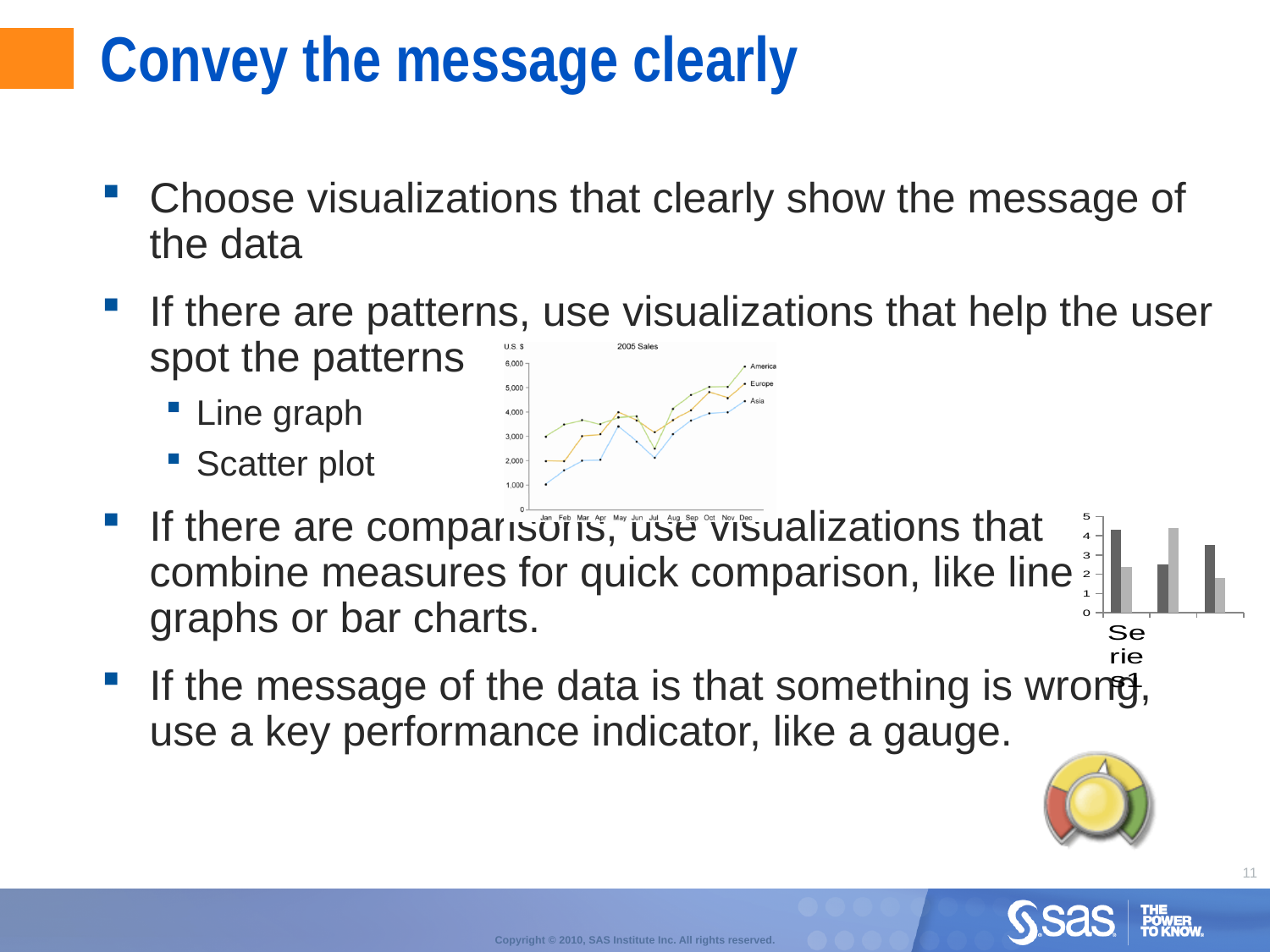
On the small bar chart on the right, is the light-coloured bar in the third group greater or less than 2? less What is the y-axis label of the '2005 Sales' chart? U.S. $ How many months are shown along the x axis of the '2005 Sales' chart? 12 On the '2005 Sales' chart, is the value for America in Dec greater or less than 5,000? greater What kind of chart is the '2005 Sales' chart? line chart On the '2005 Sales' chart, which series has the highest value in Dec? America What is the title of the line chart on the slide? 2005 Sales What kind of chart is the small chart on the right side of the slide with a y axis from 0 to 5? bar chart How many series are labelled on the '2005 Sales' chart? 3 On the '2005 Sales' chart, do the values generally rise or fall from Jan to Dec? rise On the '2005 Sales' chart, which series has the lowest value in Dec? Asia On the small bar chart on the right, how many groups of bars are there? 3